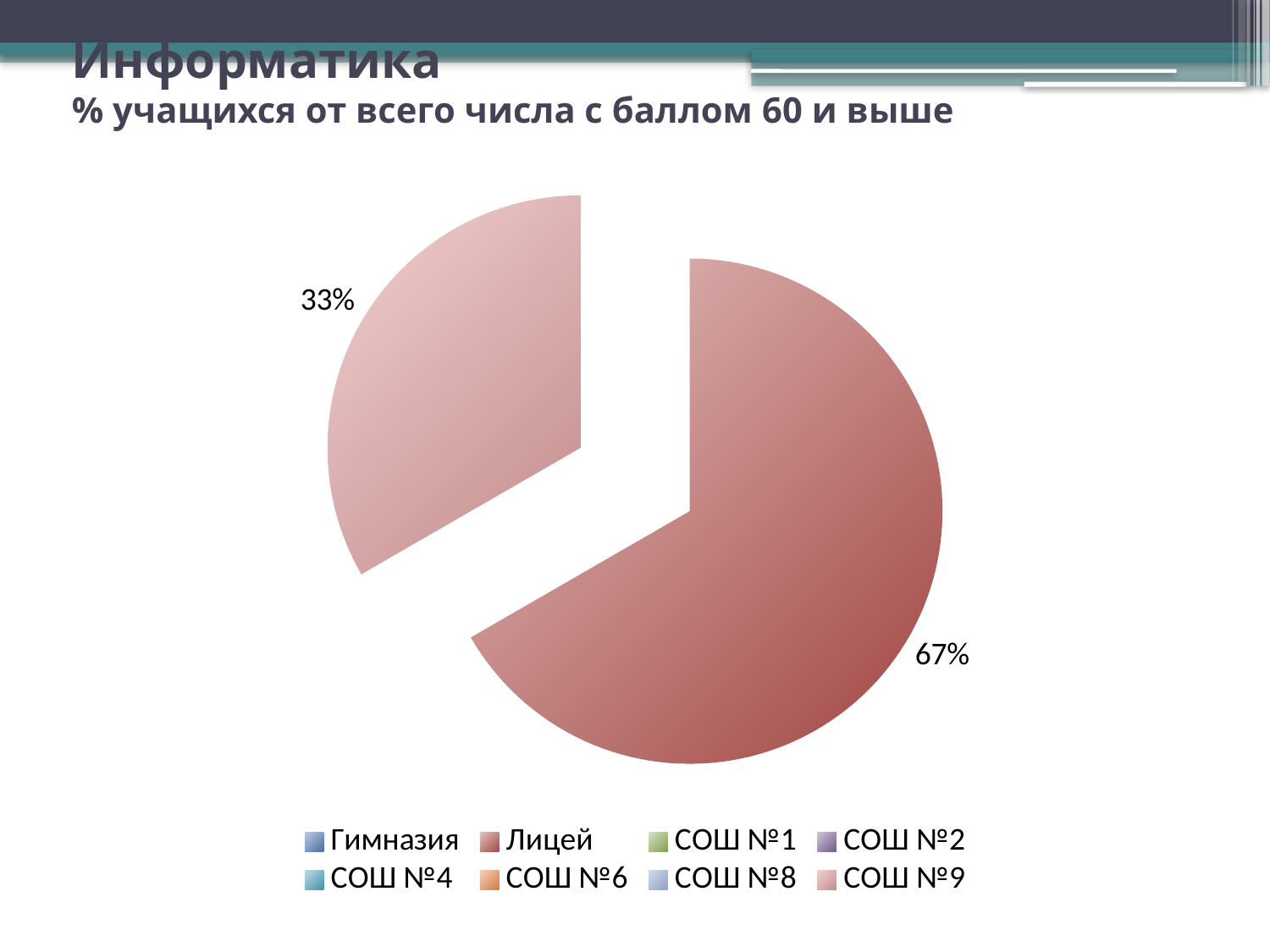
What is the subtitle of the chart on the slide? % учащихся от всего числа с баллом 60 и выше Which of the two visible slices is the smaller one? СОШ №9 What share of the pie does Лицей have? 67% What is the subject named in the slide title? Информатика Which is larger, the slice for Лицей or the slice for СОШ №9? Лицей Which category has the largest slice of the pie? Лицей What kind of chart is shown on the slide? Pie chart How many slices with data labels are visible in the pie? 2 How many categories are listed in the legend? 8 What share of the pie does СОШ №9 have? 33% What is the difference between the Лицей slice and the СОШ №9 slice? 34% Is the share for Лицей greater or less than 50%? greater